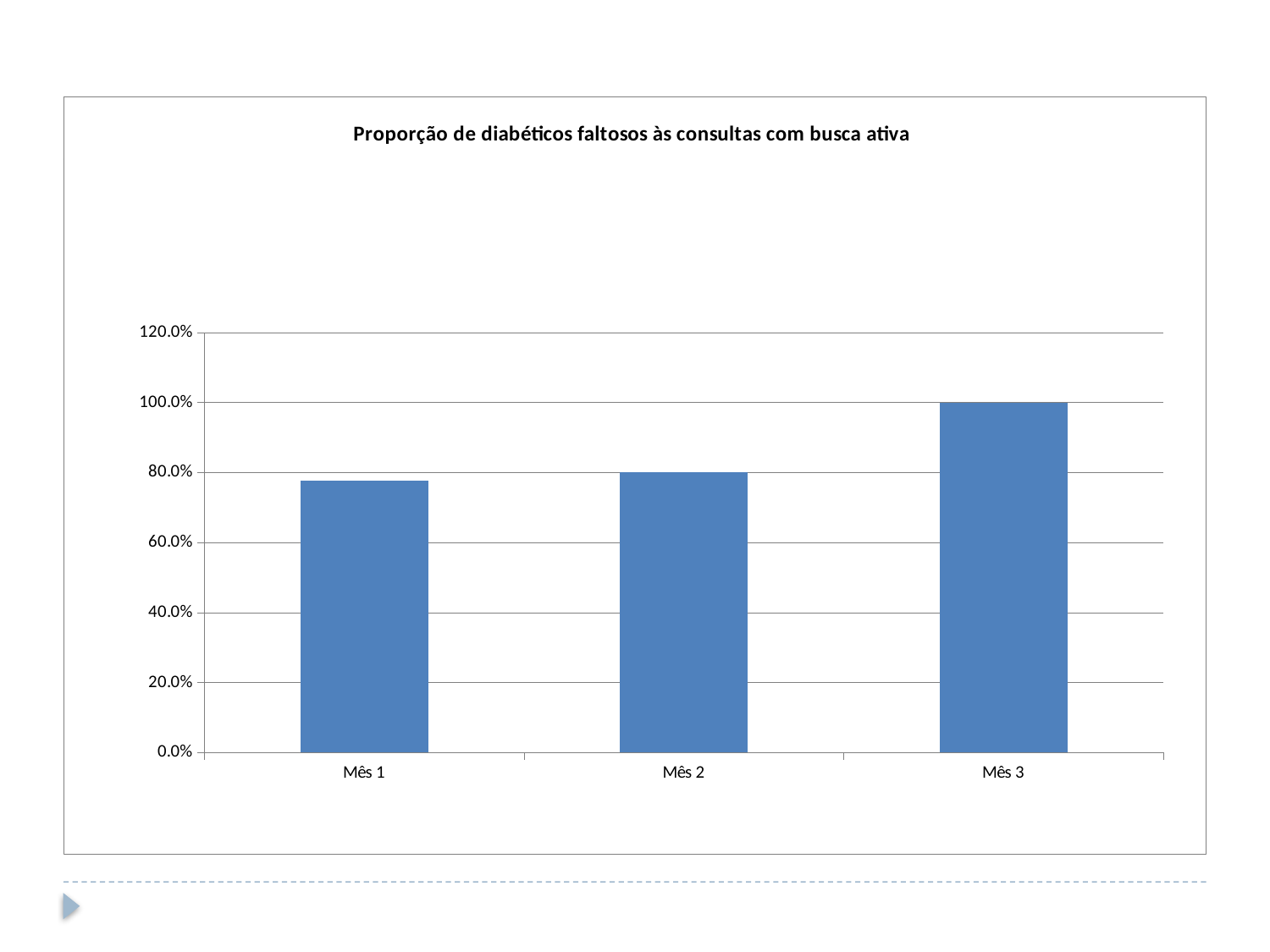
Which is larger, the value for Mês 1 or the value for Mês 3? Mês 3 Is the value for Mês 2 greater or less than 40.0%? greater Is the value for Mês 3 greater or less than 80.0%? greater Which month has the highest proportion? Mês 3 Do the values rise or fall from Mês 1 to Mês 3? rise Is the value for Mês 1 greater or less than 60.0%? greater What is the highest value shown on the y axis? 120.0% How many categories are plotted on the x axis? 3 What kind of chart is shown on the slide? bar chart Which month has the lowest proportion? Mês 1 What is the title of the chart? Proporção de diabéticos faltosos às consultas com busca ativa What is the value for Mês 3? 100.0%